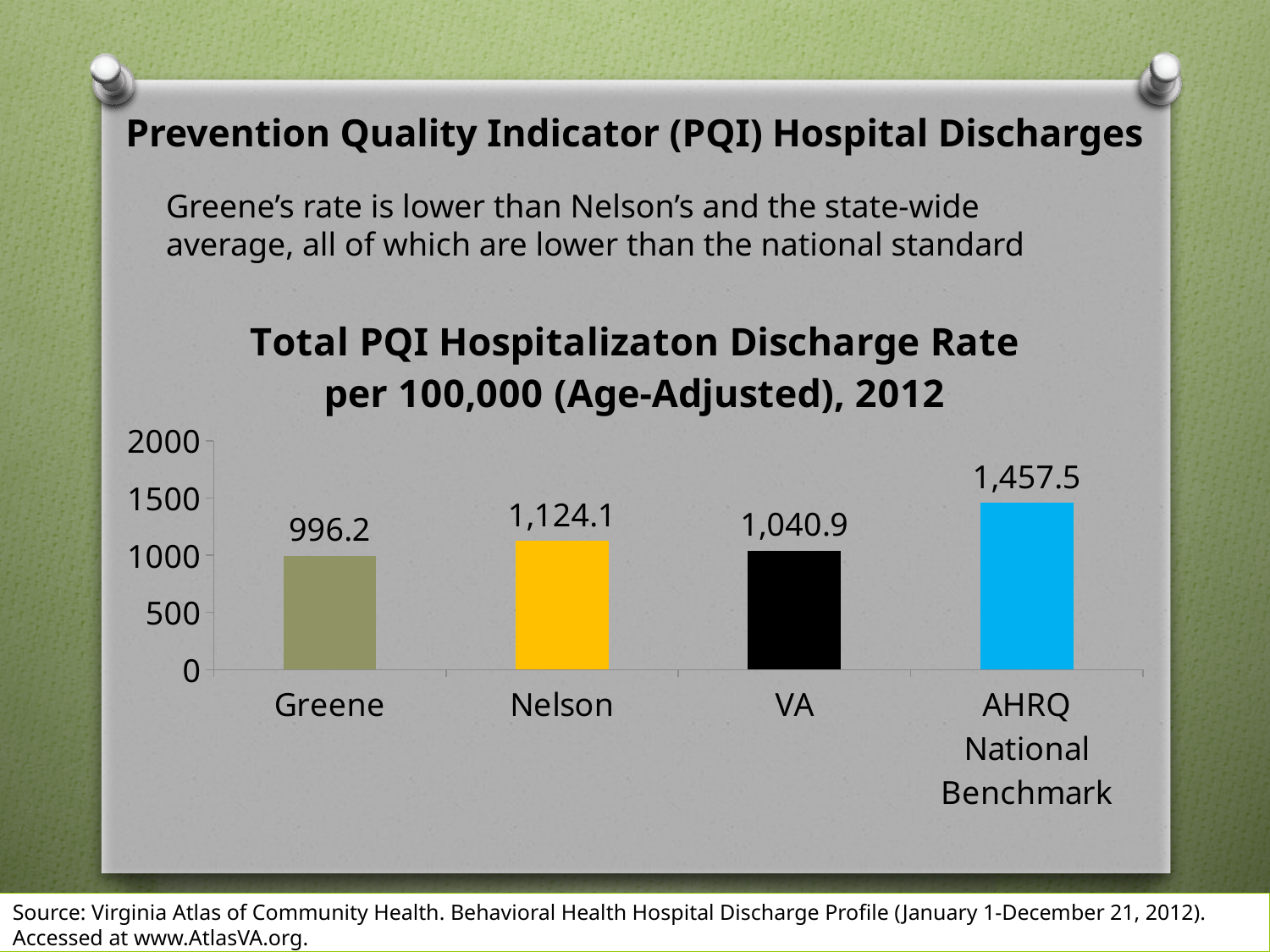
What kind of chart is shown on the slide? Bar chart What is the Total PQI Hospitalization Discharge Rate for VA? 1,040.9 Which category has the lowest Total PQI Hospitalization Discharge Rate? Greene What is the Total PQI Hospitalization Discharge Rate for Nelson? 1,124.1 What is the Total PQI Hospitalization Discharge Rate for Greene? 996.2 Which category has the highest Total PQI Hospitalization Discharge Rate? AHRQ National Benchmark What is the value shown for the AHRQ National Benchmark? 1,457.5 What is the difference between the AHRQ National Benchmark and Greene's rate? 461.3 Is the value for Greene greater or less than 1000? less How many categories are shown on the x axis of the chart? 4 What is the difference between Nelson's rate and VA's rate? 83.2 Which has a higher Total PQI Hospitalization Discharge Rate, Nelson or VA? Nelson